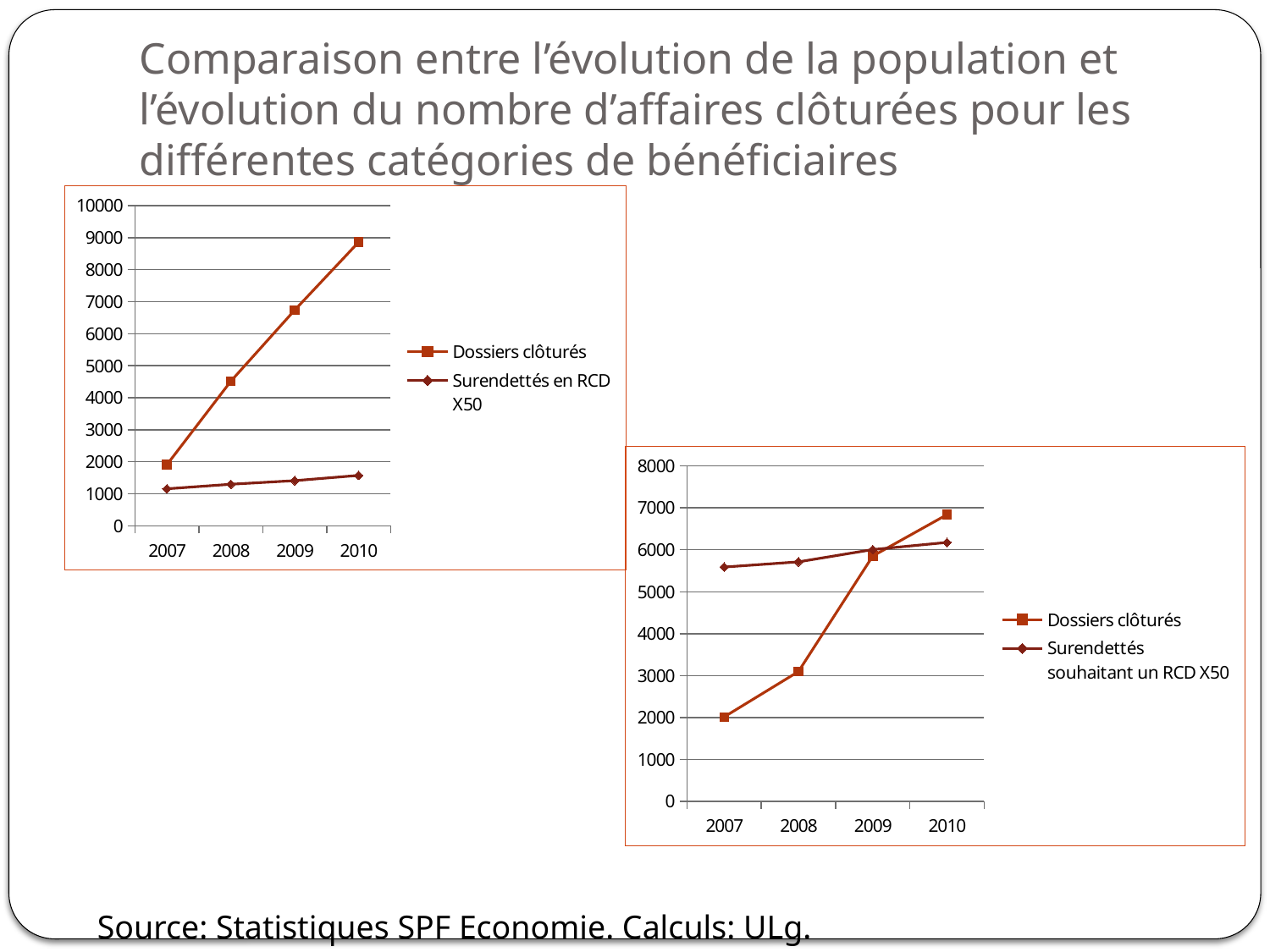
How many years are shown on the x axis of the left chart? 4 How many series does the legend of the right chart list? 2 In the right chart, which series has the higher value in 2007? Surendettés souhaitant un RCD X50 In the left chart, which series has the higher value in 2010? Dossiers clôturés In the left chart, does the Dossiers clôturés series rise or fall from 2007 to 2010? rise In the left chart, is the value for Surendettés en RCD X50 in 2007 greater or less than 2000? less What kind of chart is the chart on the left of the slide? line chart In the left chart, is the value for Dossiers clôturés in 2008 greater or less than 4000? greater In the right chart, in which year is the value for Dossiers clôturés highest? 2010 In the right chart, is the value for Dossiers clôturés in 2008 greater or less than 4000? less How many series does the legend of the left chart list? 2